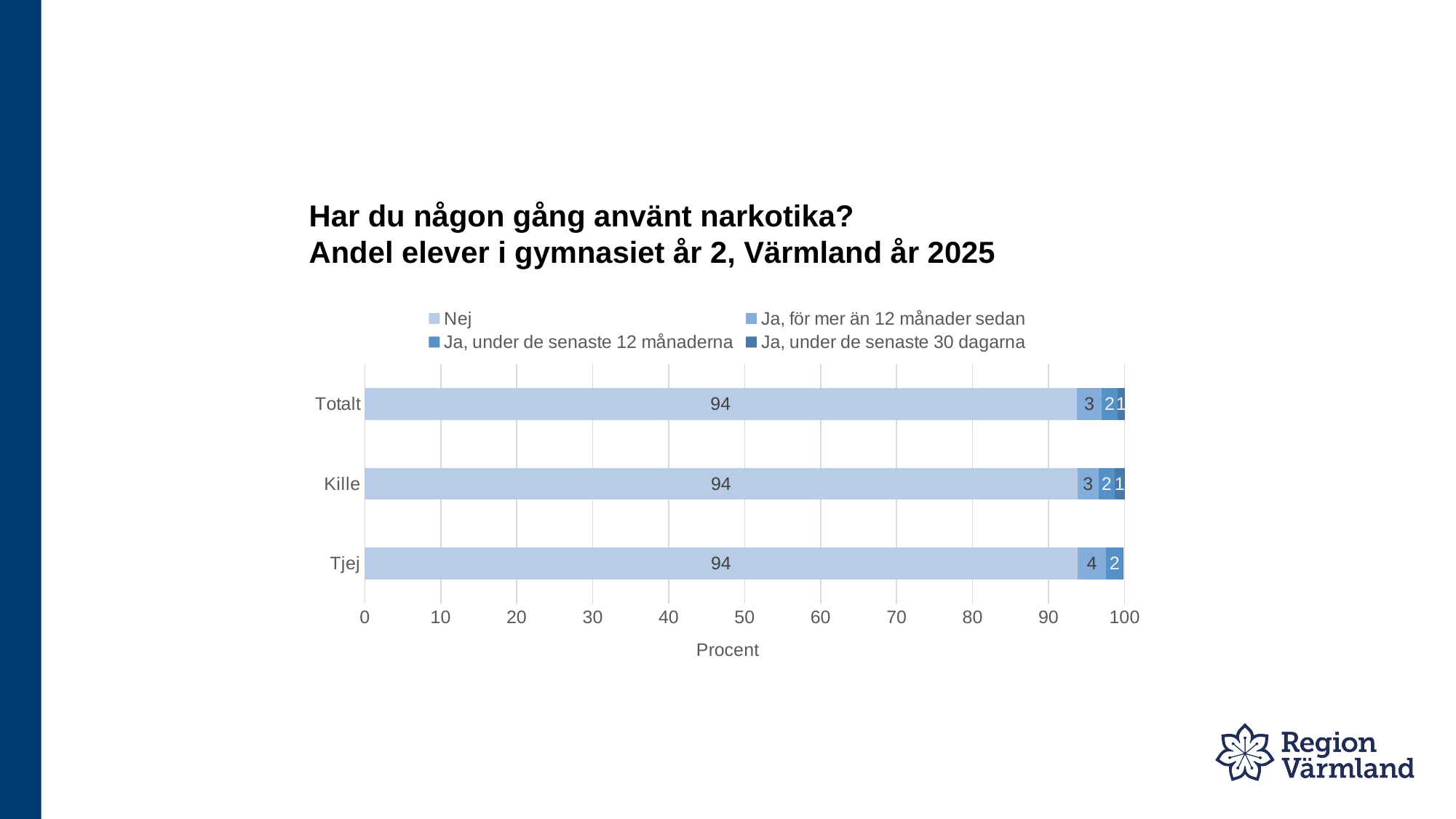
Is the "Ja, för mer än 12 månader sedan" value larger for Tjej or for Kille? Tjej How many categories are shown on the y axis? 3 Which category has the highest value for "Ja, för mer än 12 månader sedan"? Tjej What kind of chart is shown on the slide? Stacked bar chart What percentage of students in the Totalt category answered "Nej"? 94 How many series does the legend list? 4 Is the "Nej" value for Kille greater or less than 90? greater What is the total of the stacked bar for Totalt? 100 What is the difference between the "Ja, för mer än 12 månader sedan" values for Tjej and Kille? 1 What is the value for "Ja, under de senaste 30 dagarna" in the Kille category? 1 What is the value for "Ja, under de senaste 12 månaderna" in the Totalt category? 2 What is the value for "Ja, för mer än 12 månader sedan" in the Tjej category? 4